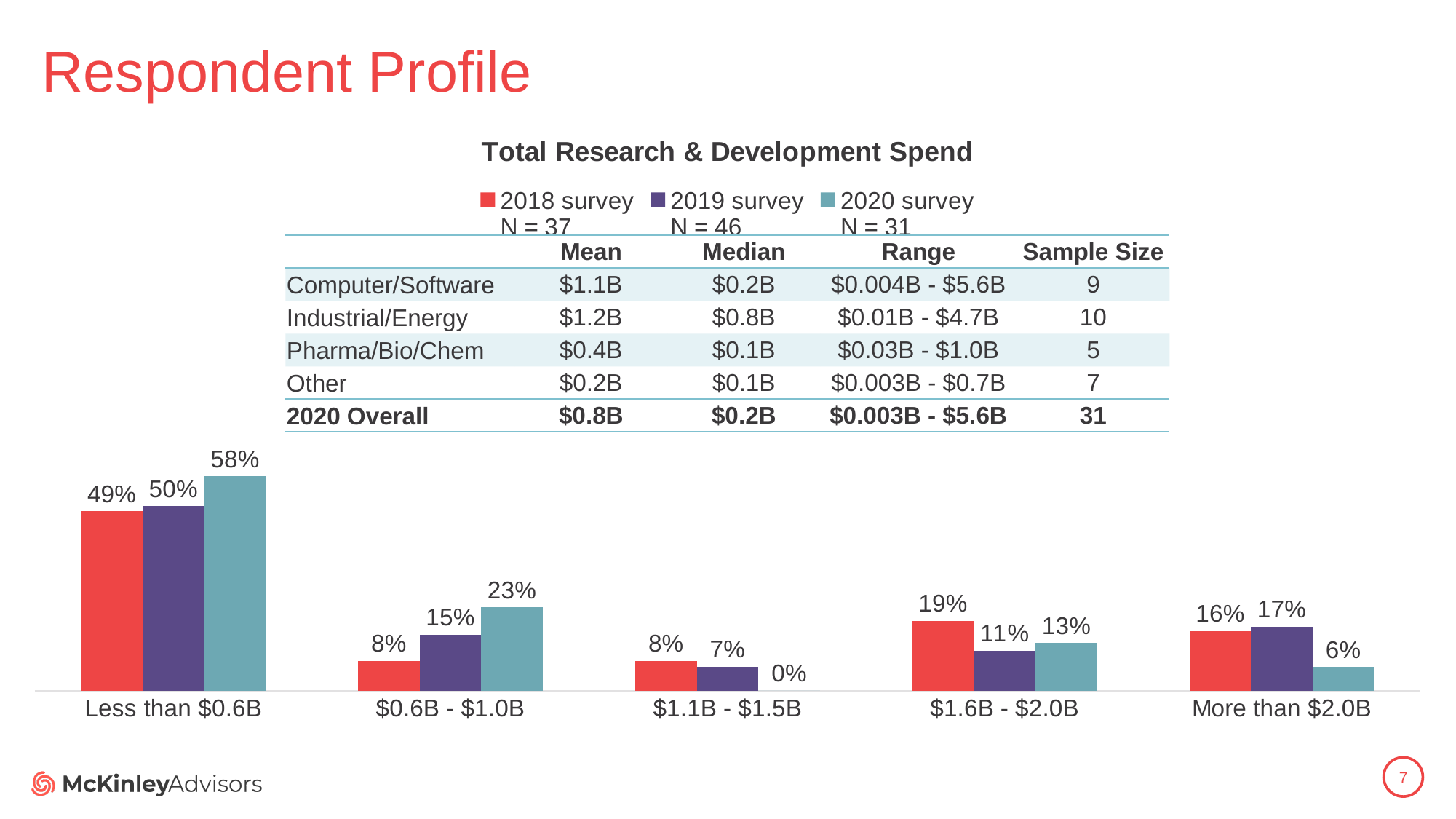
How many series does the chart legend list? 3 What is the value for the 2020 survey in the 'More than $2.0B' category? 6% What is the title of the chart? Total Research & Development Spend How many categories are shown on the x axis of the chart? 5 What is the value for the 2019 survey in the '$0.6B - $1.0B' category? 15% Which category has the lowest value for the 2020 survey? $1.1B - $1.5B What kind of chart is shown on the slide? Bar chart What is the value for the 2020 survey in the 'Less than $0.6B' category? 58% What is the value for the 2018 survey in the '$1.6B - $2.0B' category? 19% What is the difference between the 2020 survey and 2018 survey values in the 'Less than $0.6B' category? 9% Which category has the highest value for the 2018 survey? Less than $0.6B Which is larger in the 'More than $2.0B' category: the 2018 survey value or the 2019 survey value? 2019 survey